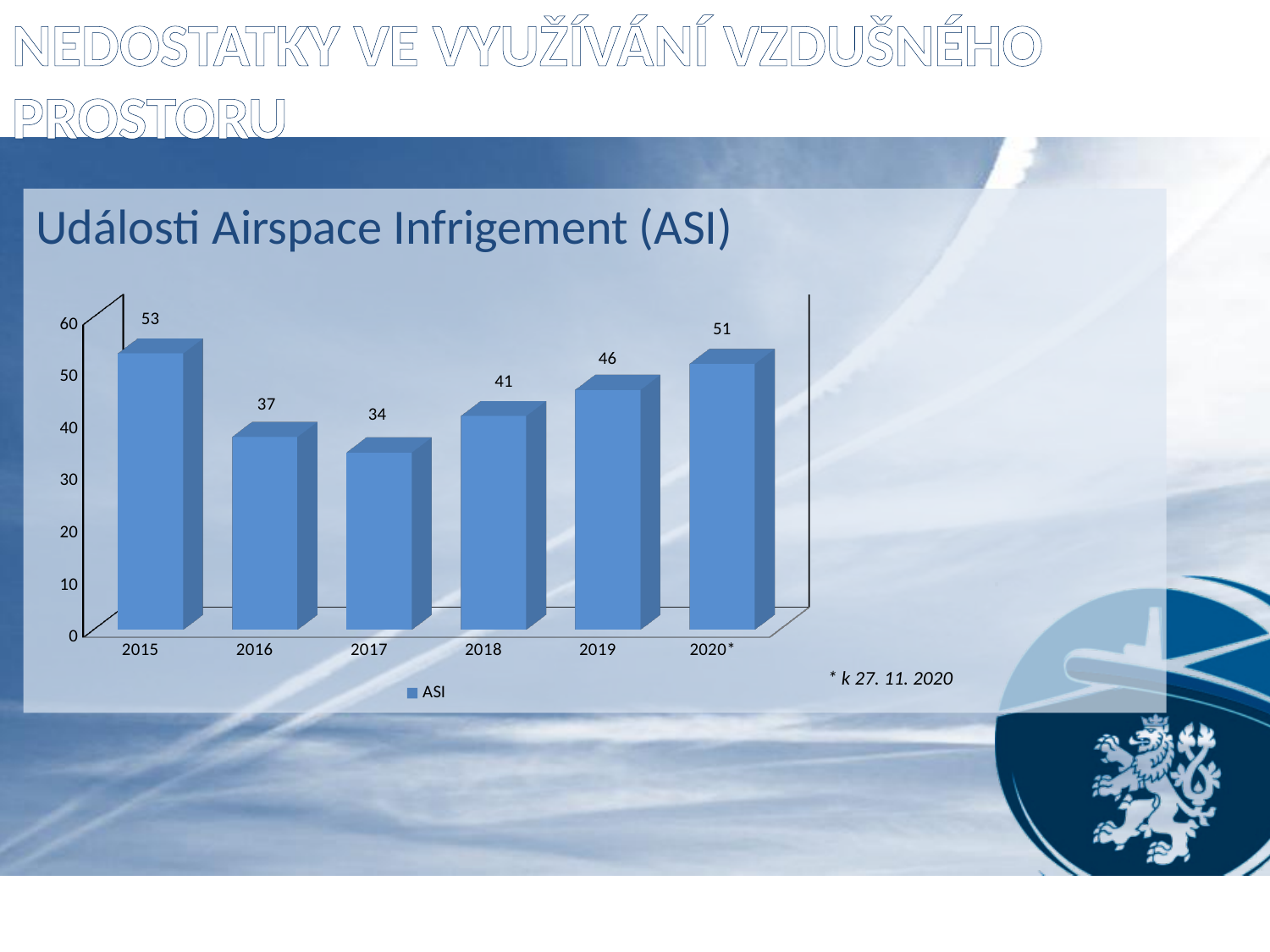
Do the ASI values rise or fall from 2017 to 2020*? rise What is the difference between the ASI values for 2020* and 2019? 5 Which year has the highest ASI value? 2015 What kind of chart is shown on the slide? bar chart Which year has the lowest ASI value? 2017 Is the ASI value for 2019 greater or less than 40? greater Which is larger, the ASI value for 2016 or for 2018? 2018 What is the difference between the ASI values for 2015 and 2017? 19 How many years are shown on the x axis? 6 What is the ASI value for 2017? 34 What is the ASI value for 2020*? 51 What is the ASI value for 2015? 53